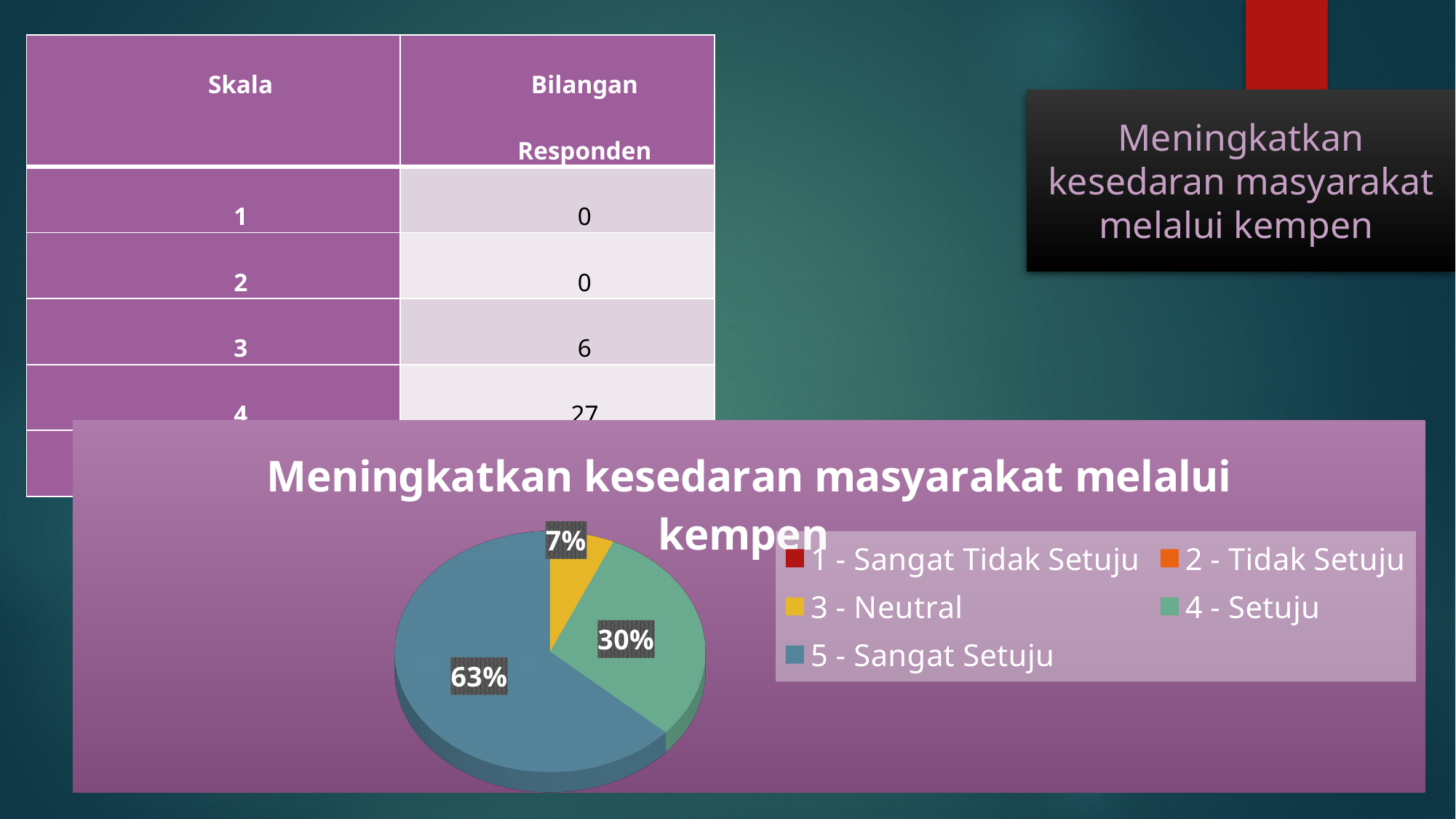
Which category has the largest slice of the pie? 5 - Sangat Setuju What share of the pie does 5 - Sangat Setuju have? 63% What share of the pie does 3 - Neutral have? 7% How many slices are visible in the pie? 3 What share of the pie does 4 - Setuju have? 30% What kind of chart is shown on the slide? Pie chart What is the title of the chart? Meningkatkan kesedaran masyarakat melalui kempen What colour is the 5 - Sangat Setuju slice in the pie? Blue Of the three slices drawn in the pie, which is the smallest? 3 - Neutral What is the difference in percentage points between the 5 - Sangat Setuju slice and the 4 - Setuju slice? 33 percentage points Which slice is larger, 4 - Setuju or 3 - Neutral? 4 - Setuju How many categories does the legend list? 5